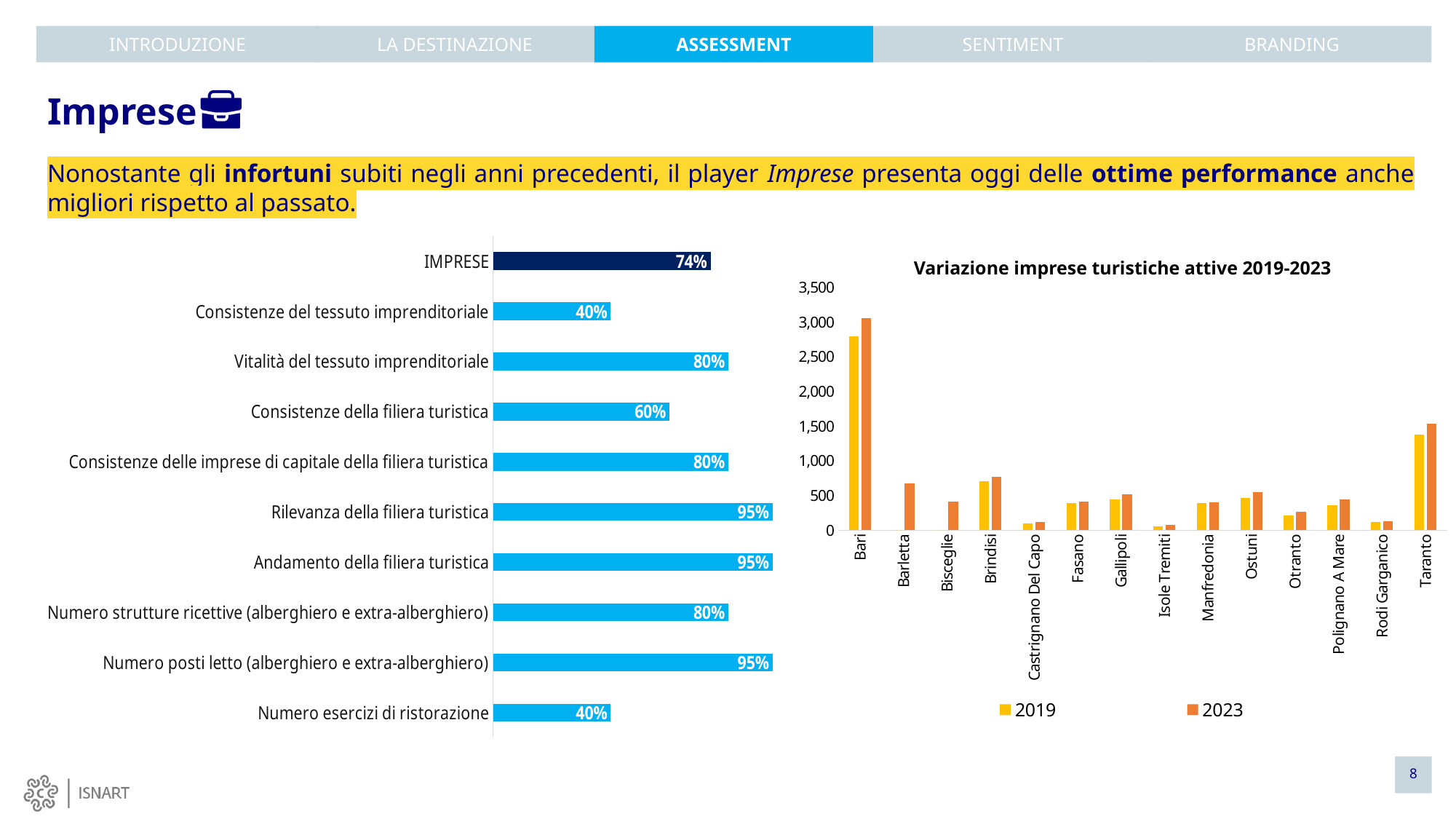
In the chart 'Variazione imprese turistiche attive 2019-2023', which category has the highest value for 2023? Bari In the chart 'Variazione imprese turistiche attive 2019-2023', how many categories are shown on the x axis? 14 In the left bar chart, which is larger: Vitalità del tessuto imprenditoriale or Consistenze della filiera turistica? Vitalità del tessuto imprenditoriale In the chart 'Variazione imprese turistiche attive 2019-2023', is the value for Taranto in 2019 greater or less than 1,500? less In the left bar chart, what is the difference between Rilevanza della filiera turistica and Consistenze del tessuto imprenditoriale? 55% In the left bar chart, how many bars are shown? 10 In the left bar chart, what is the value for Consistenze della filiera turistica? 60% In the left bar chart, what is the value for IMPRESE? 74% In the chart 'Variazione imprese turistiche attive 2019-2023', how many series does the legend list? 2 In the left bar chart, what is the value for Numero esercizi di ristorazione? 40% What kind of chart is the left chart? Bar chart